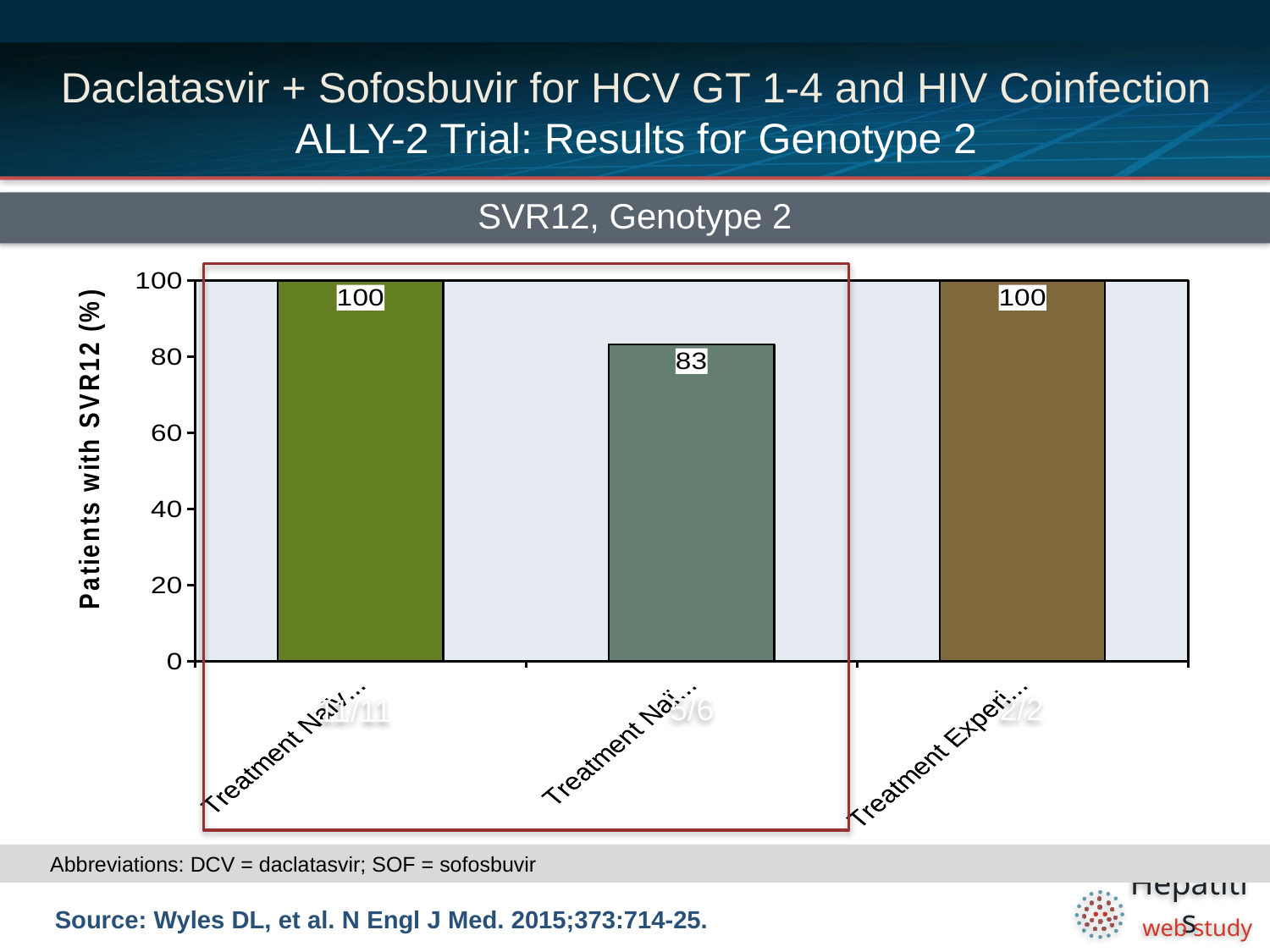
How many bars are plotted in the SVR12, Genotype 2 chart? 3 What is the title of the chart? SVR12, Genotype 2 Which bar has the lowest value in the chart? the middle bar How many bars in the chart reach a value of 100? 2 Which is larger, the value of the leftmost bar or the value of the middle bar? the leftmost bar Is the value of the middle bar greater or less than 80? greater What is the value shown on the middle bar of the chart? 83 What is the difference between the leftmost bar's value and the middle bar's value? 17 What is the label on the vertical axis of the chart? Patients with SVR12 (%) What is the value shown on the leftmost bar of the chart? 100 What kind of chart is shown on the slide? bar chart What is the value shown on the rightmost bar (Treatment Experienced) of the chart? 100